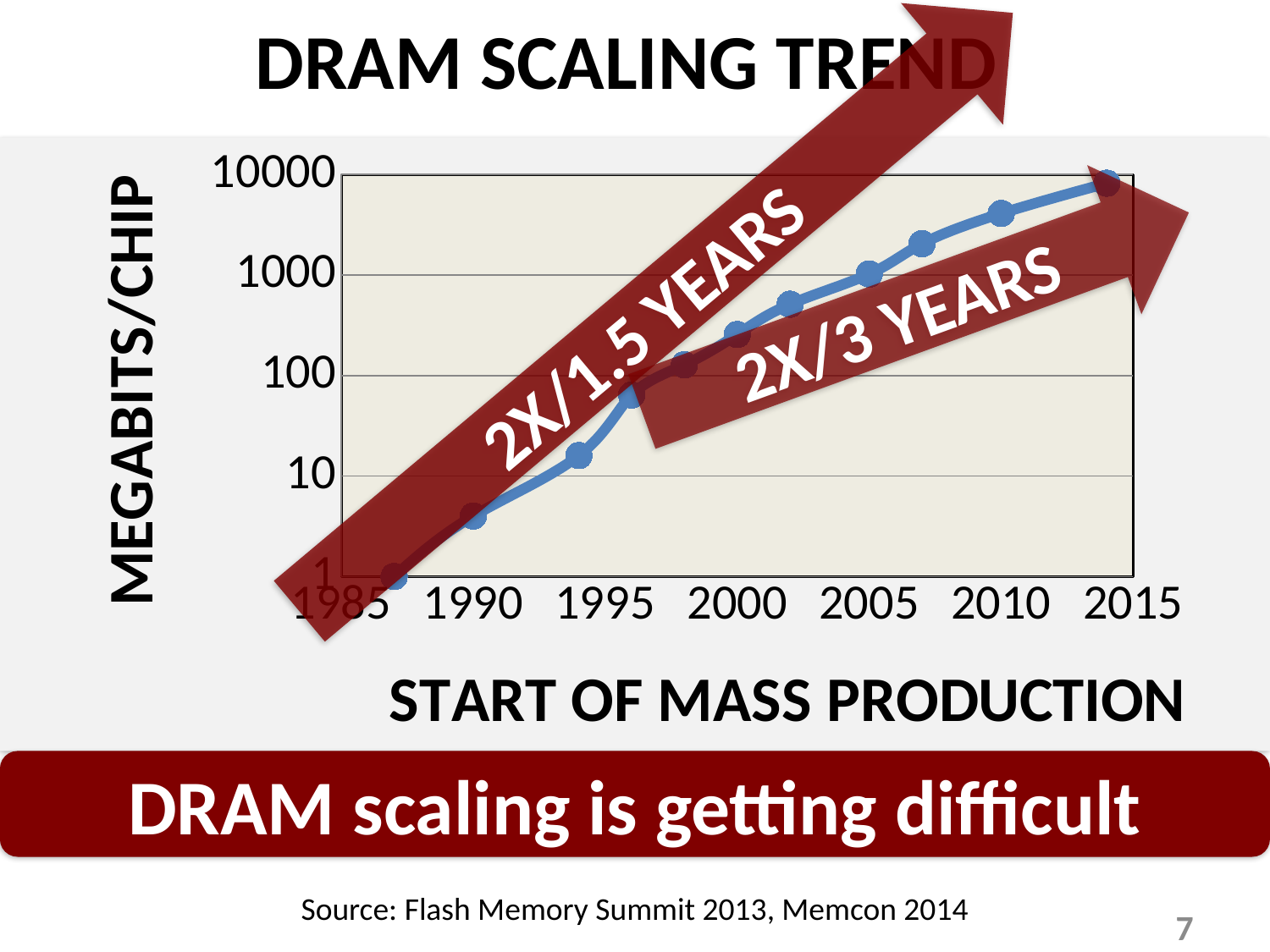
Is the value for the point near 2014 greater or less than 1000? greater Which plotted point has the highest value? the last point, near 2014 Which has the larger value, the point near 1990 or the point near 2010? the point near 2010 What is the title of the chart? DRAM SCALING TREND Is the value for the point near 1990 greater or less than 10? less Which plotted point has the lowest value? the first point, near 1987 Do the plotted values rise or fall as the year increases along the x axis? rise What is the label of the vertical axis? MEGABITS/CHIP Is the value for the point near 2010 greater or less than 1000? greater What kind of chart is shown on the slide? line chart